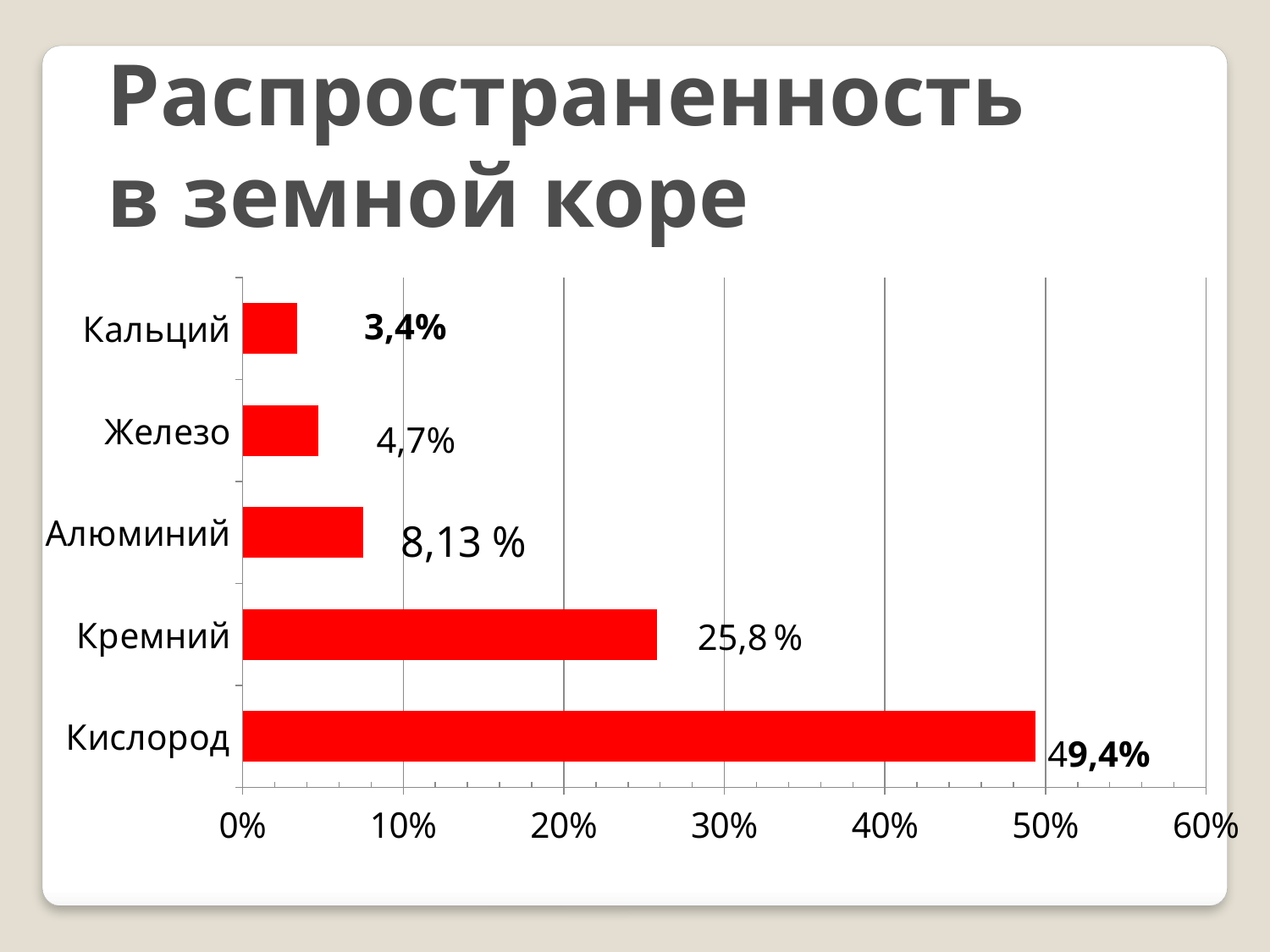
Is the value for Кремний greater or less than 30%? less Which category has the lowest value? Кальций Which is larger, the value for Железо or the value for Алюминий? Алюминий How many categories are shown in the chart? 5 What is the difference between the values for Кислород and Кремний? 23,6% What is the value shown for Алюминий? 8,13 % What is the value shown for Кремний? 25,8 % Which category has the highest value? Кислород What kind of chart is shown on the slide? bar chart What is the value shown for Кислород? 49,4% What is the value shown for Кальций? 3,4% What is the value shown for Железо? 4,7%